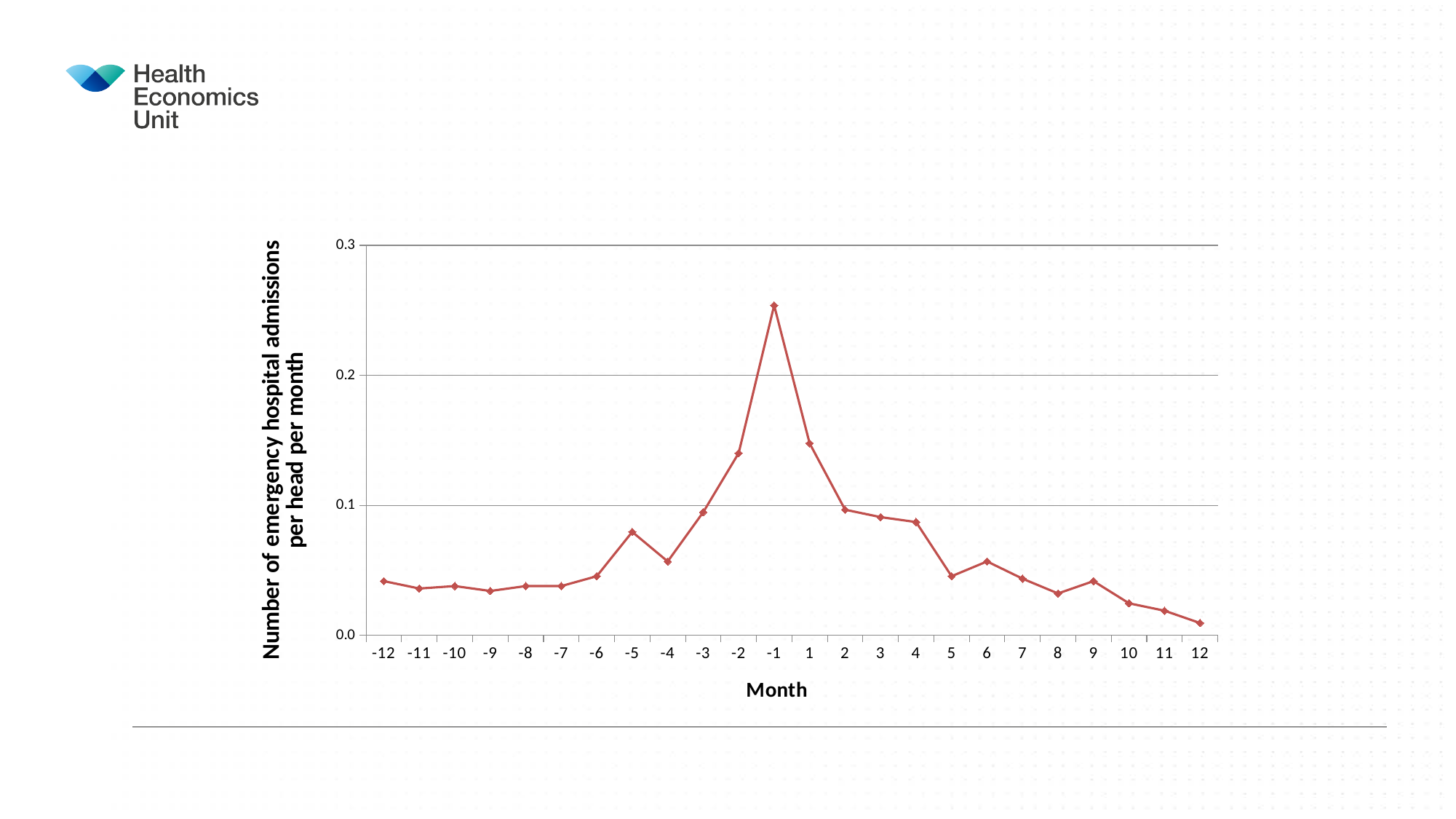
Which has the larger value, month -5 or month -4? month -5 What is the label on the y axis? Number of emergency hospital admissions per head per month How many months are plotted along the x axis? 24 Which month has the lowest number of emergency hospital admissions per head per month? 12 Is the value for month -12 greater or less than 0.1? less Which has the larger value, month -1 or month 1? month -1 Is the value for month -1 greater or less than 0.2? greater Which month has the highest number of emergency hospital admissions per head per month? -1 Is the value for month -2 greater or less than 0.1? greater Do the values generally rise or fall from month 1 to month 12? fall What kind of chart is shown on the slide? line chart